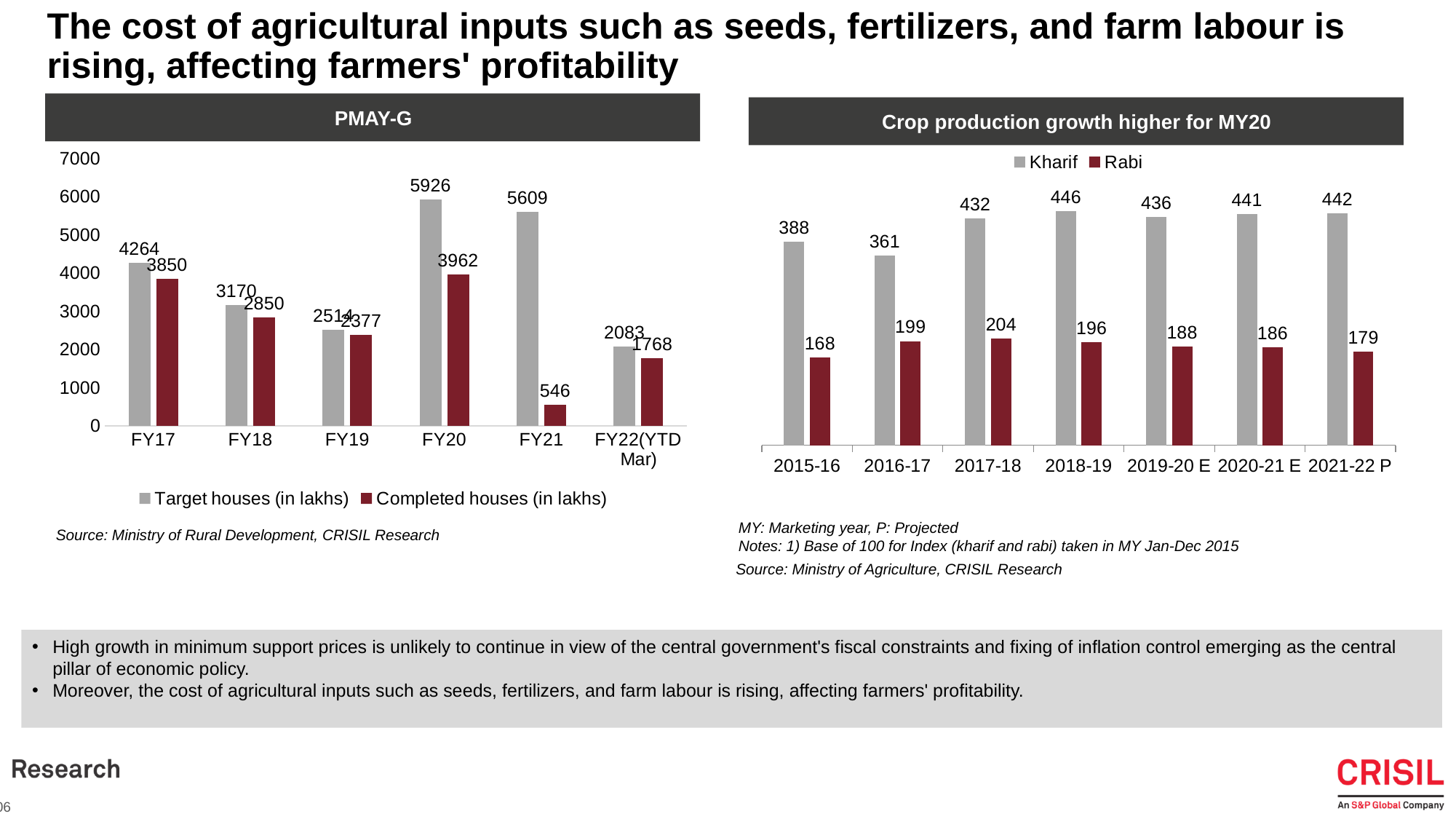
In the 'Crop production growth higher for MY20' chart, what is the Kharif value for 2018-19? 446 In the 'Crop production growth higher for MY20' chart, is the Kharif value for 2016-17 larger or smaller than the Kharif value for 2017-18? smaller In the PMAY-G chart, what is the value of Target houses (in lakhs) for FY20? 5926 In the 'Crop production growth higher for MY20' chart, which year has the highest Rabi value? 2017-18 What type of chart is the 'Crop production growth higher for MY20' chart? bar chart In the 'Crop production growth higher for MY20' chart, what is the Rabi value for 2015-16? 168 In the PMAY-G chart, which fiscal year has the lowest value for Completed houses (in lakhs)? FY21 In the PMAY-G chart, how many fiscal year categories are shown on the x axis? 6 In the 'Crop production growth higher for MY20' chart, how many series does the legend list? 2 In the PMAY-G chart, which fiscal year has the highest value for Target houses (in lakhs)? FY20 In the PMAY-G chart, what is the value of Completed houses (in lakhs) for FY21? 546 In the PMAY-G chart, what is the difference between Target houses and Completed houses for FY21? 5063